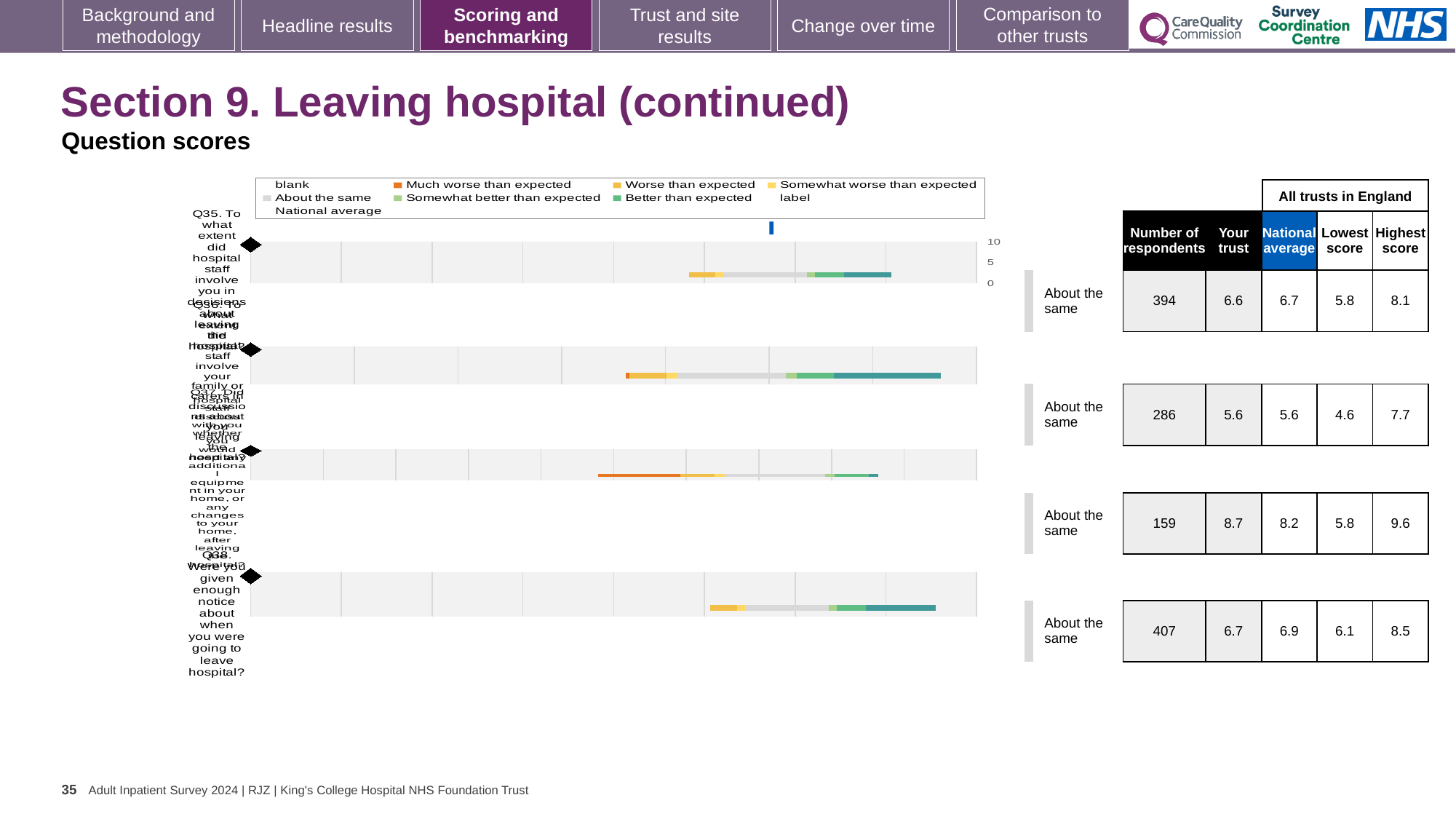
Which legend entry is shown in dark teal? Better than expected In the table beside the charts, is the 'Your trust' score for Q36 larger or smaller than the 'Your trust' score for Q35? smaller How many entries does the legend at the top of the charts list? 9 In the table beside the charts, what is the difference between the 'Your trust' score and the 'National average' for Q37? 0.5 What kind of chart is used to show the question scores on this slide? bar chart How many separate benchmark charts are shown on the slide? 4 Which legend entry is shown in orange? Much worse than expected What is the highest value shown on the axis scale at the right of the first chart? 10 In the table beside the charts, which question has the highest 'Your trust' score? Q37 What benchmark category is written next to each of the four charts? About the same In the table beside the charts, what is the 'Your trust' score for Q38? 6.7 In the table beside the charts, what is the 'Your trust' score for Q35? 6.6